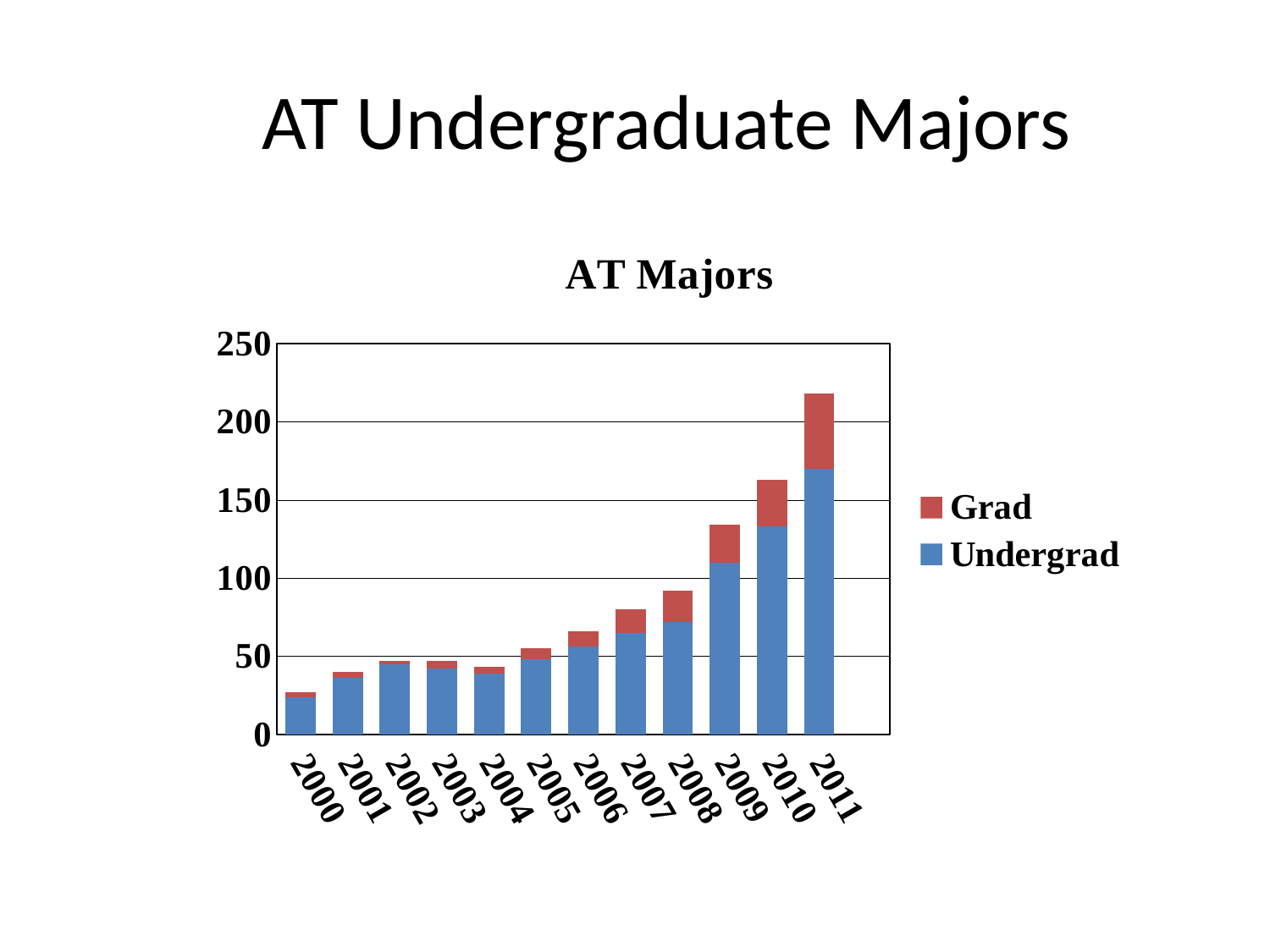
What kind of chart is shown on the slide? Stacked bar chart Which year has the highest total number of AT majors? 2011 What is the title of the chart? AT Majors How many years are shown on the x axis? 12 Is the total for 2007 greater or less than 100? less Which year has a larger total, 2009 or 2006? 2009 Is the total for 2011 greater or less than 200? greater Is the total for 2000 greater or less than 50? less How many series does the legend list? 2 Which year has the lowest total number of AT majors? 2000 Do the totals generally rise or fall from 2000 to 2011? rise